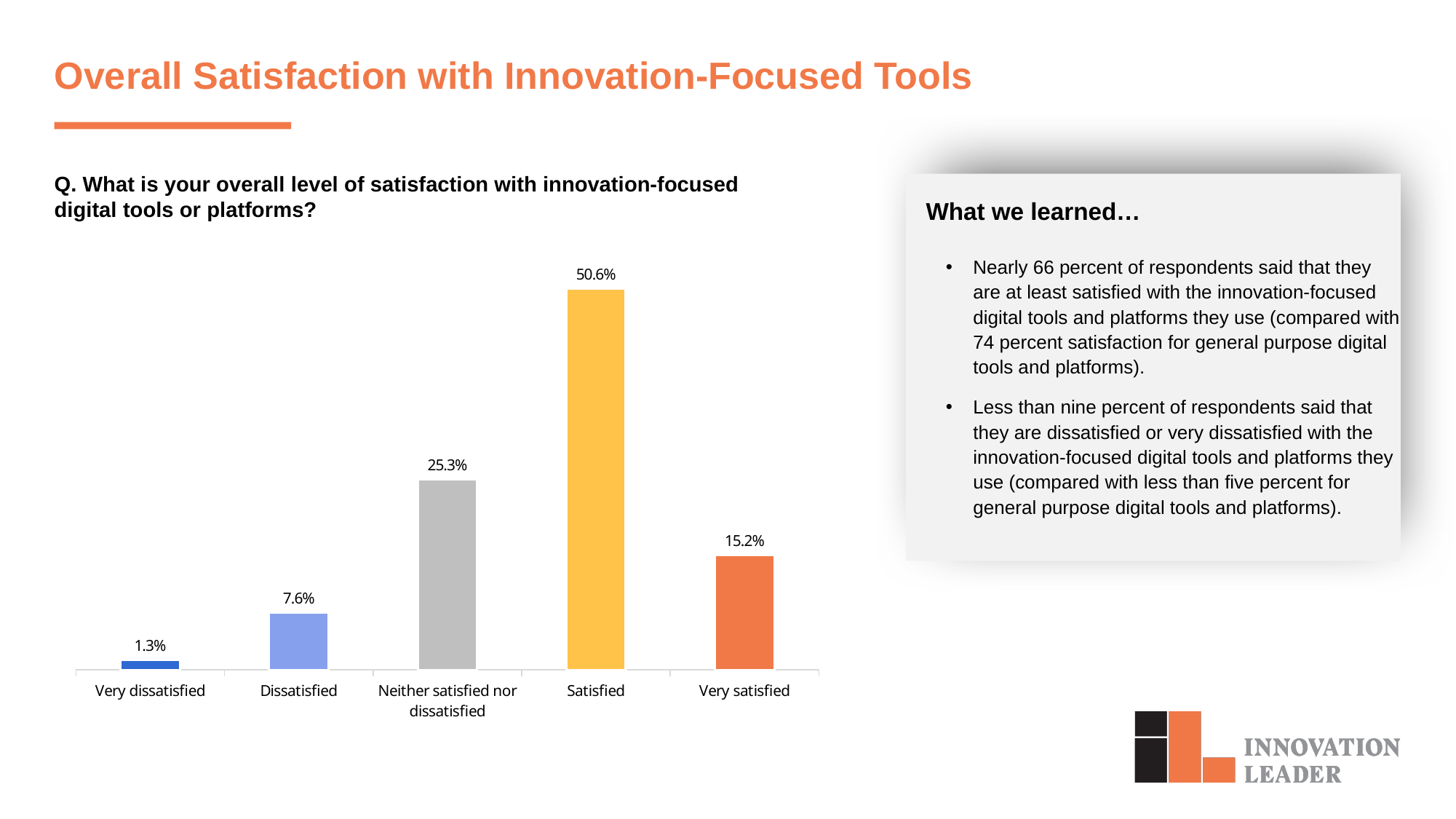
Which is larger, the value for Neither satisfied nor dissatisfied or the value for Very satisfied? Neither satisfied nor dissatisfied Which satisfaction category has the lowest percentage? Very dissatisfied What percentage of respondents said they are Satisfied with innovation-focused digital tools or platforms? 50.6% How many satisfaction categories are shown on the chart? 5 What colour is the bar for Satisfied? Yellow What is the value shown for Very satisfied? 15.2% Which satisfaction category has the highest percentage? Satisfied What is the difference in percentage points between Dissatisfied and Very dissatisfied? 6.3 What is the difference in percentage points between Satisfied and Very satisfied? 35.4 What type of chart is used to show the satisfaction levels? Bar chart What percentage of respondents said they are Very dissatisfied? 1.3% What is the value shown for Neither satisfied nor dissatisfied? 25.3%